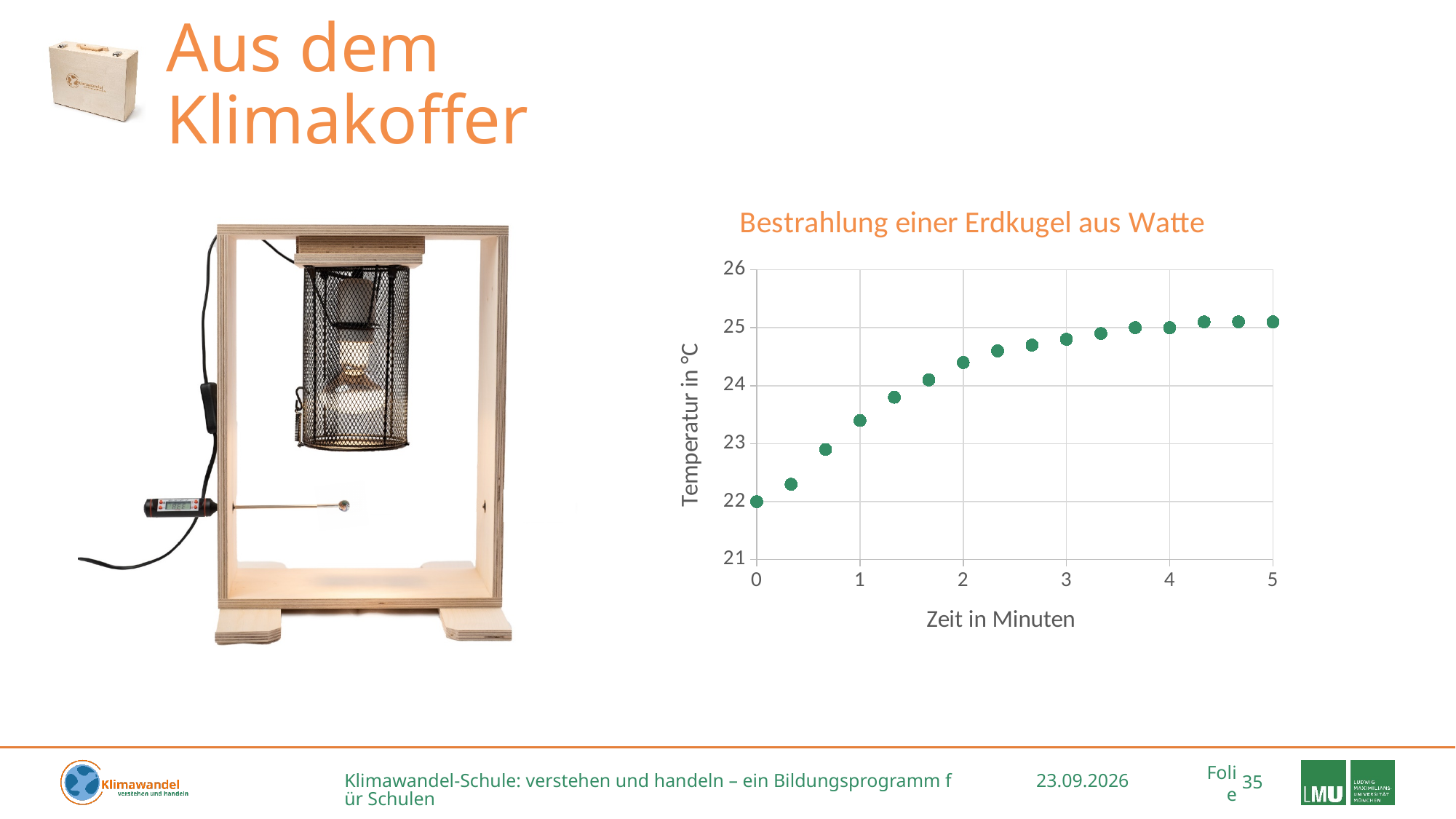
Is the temperature at 3 minutes greater or less than 25? less What is the temperature at 0 minutes? 22 Does the temperature rise or fall as time increases? rise Is the temperature at 1 minute greater or less than 23? greater Which is larger, the temperature at 1 minute or at 3 minutes? 3 minutes What is the temperature at 4 minutes? 25 What kind of chart is shown on the slide? scatter chart Is the temperature at 2 minutes greater or less than 24? greater How many data points are plotted in the chart? 16 What is the title of the chart? Bestrahlung einer Erdkugel aus Watte What is the label of the y axis of the chart? Temperatur in °C At which time is the temperature lowest? 0 minutes